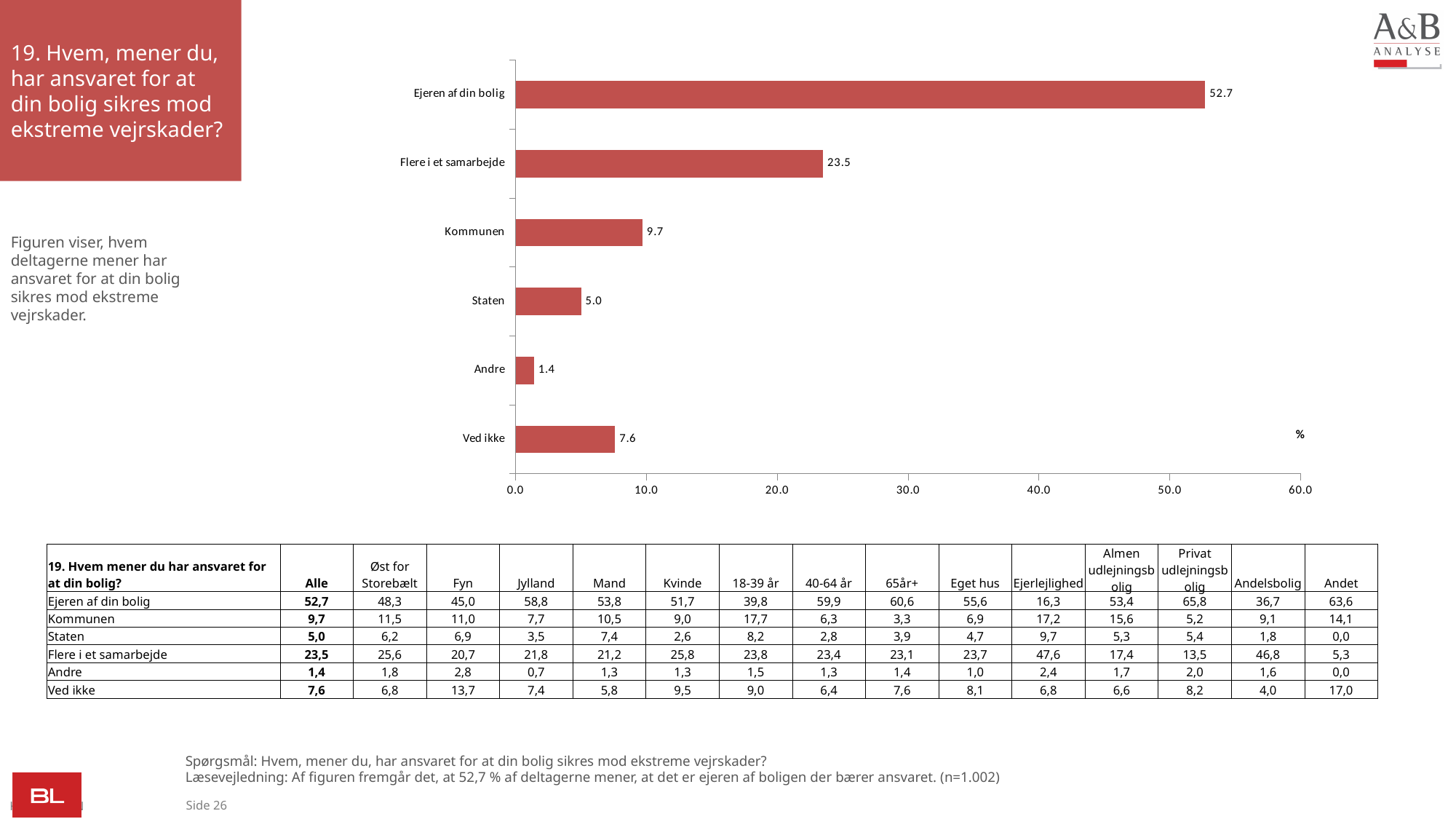
What kind of chart is shown on the slide? bar chart What value is shown for "Ved ikke" in the bar chart? 7.6 Is the value for "Kommunen" greater or less than 10.0? less How many categories are shown in the bar chart? 6 What value is shown for "Ejeren af din bolig" in the bar chart? 52.7 Which is larger in the bar chart: the value for "Staten" or the value for "Ved ikke"? Ved ikke What is the maximum value shown on the x axis of the bar chart? 60.0 What value is shown for "Flere i et samarbejde" in the bar chart? 23.5 What is the difference between the values for "Ejeren af din bolig" and "Flere i et samarbejde"? 29.2 Which category has the highest value in the bar chart? Ejeren af din bolig What value is shown for "Kommunen" in the bar chart? 9.7 Which category has the lowest value in the bar chart? Andre